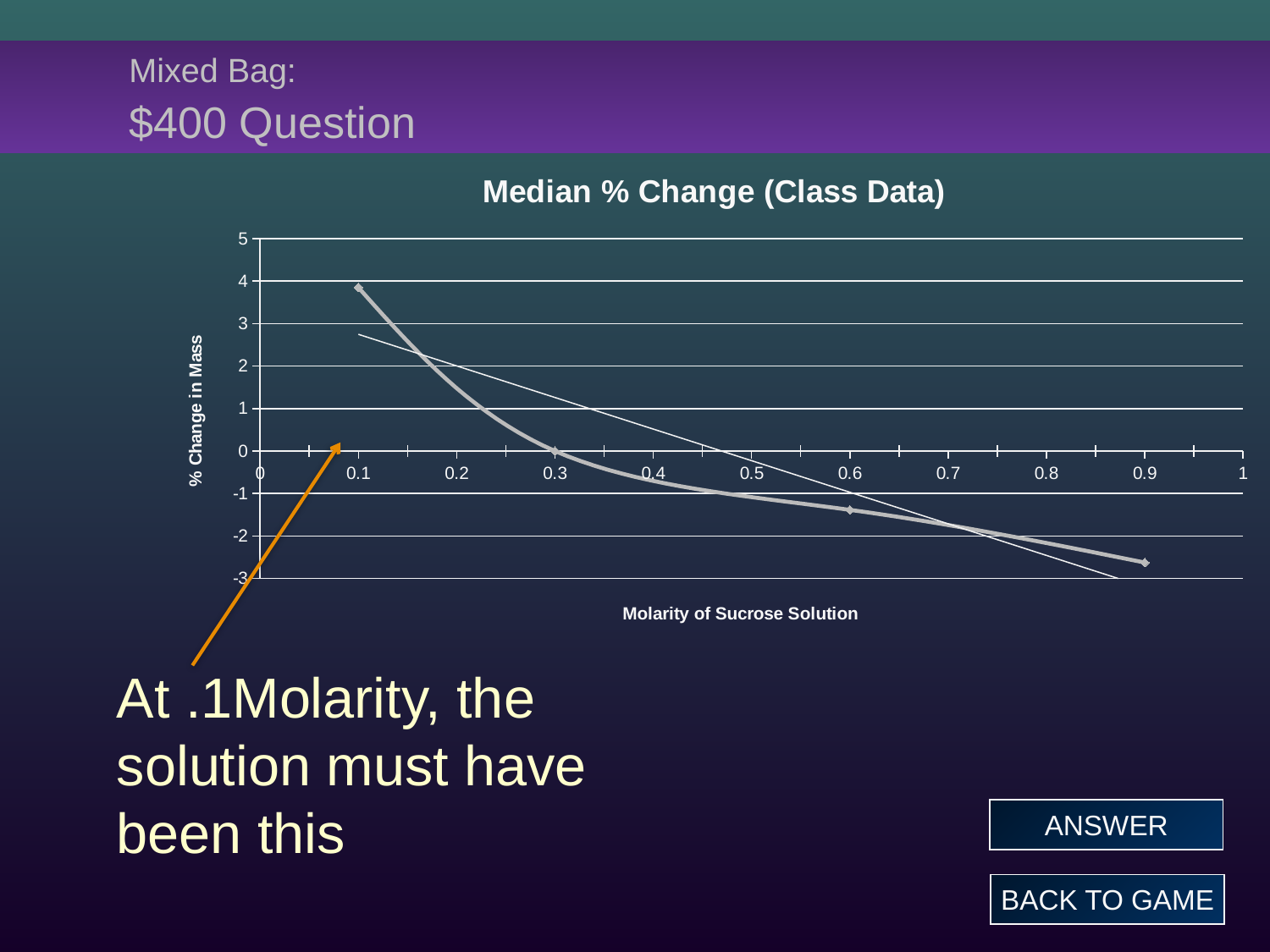
What kind of chart is shown on the slide? line chart Is the % change in mass at 0.1 molarity greater or less than 3? greater Is the % change in mass at 0.6 molarity greater or less than -1? less At which molarity is the % change in mass highest? 0.1 Which has a larger % change in mass, 0.1 molarity or 0.9 molarity? 0.1 molarity At which molarity is the % change in mass lowest? 0.9 How many data points are marked on the plotted line? 4 Is the % change in mass at 0.9 molarity greater or less than -2? less What is the title of the chart? Median % Change (Class Data) Do the plotted values rise or fall as molarity increases along the x axis? fall What is the label on the vertical axis of the chart? % Change in Mass